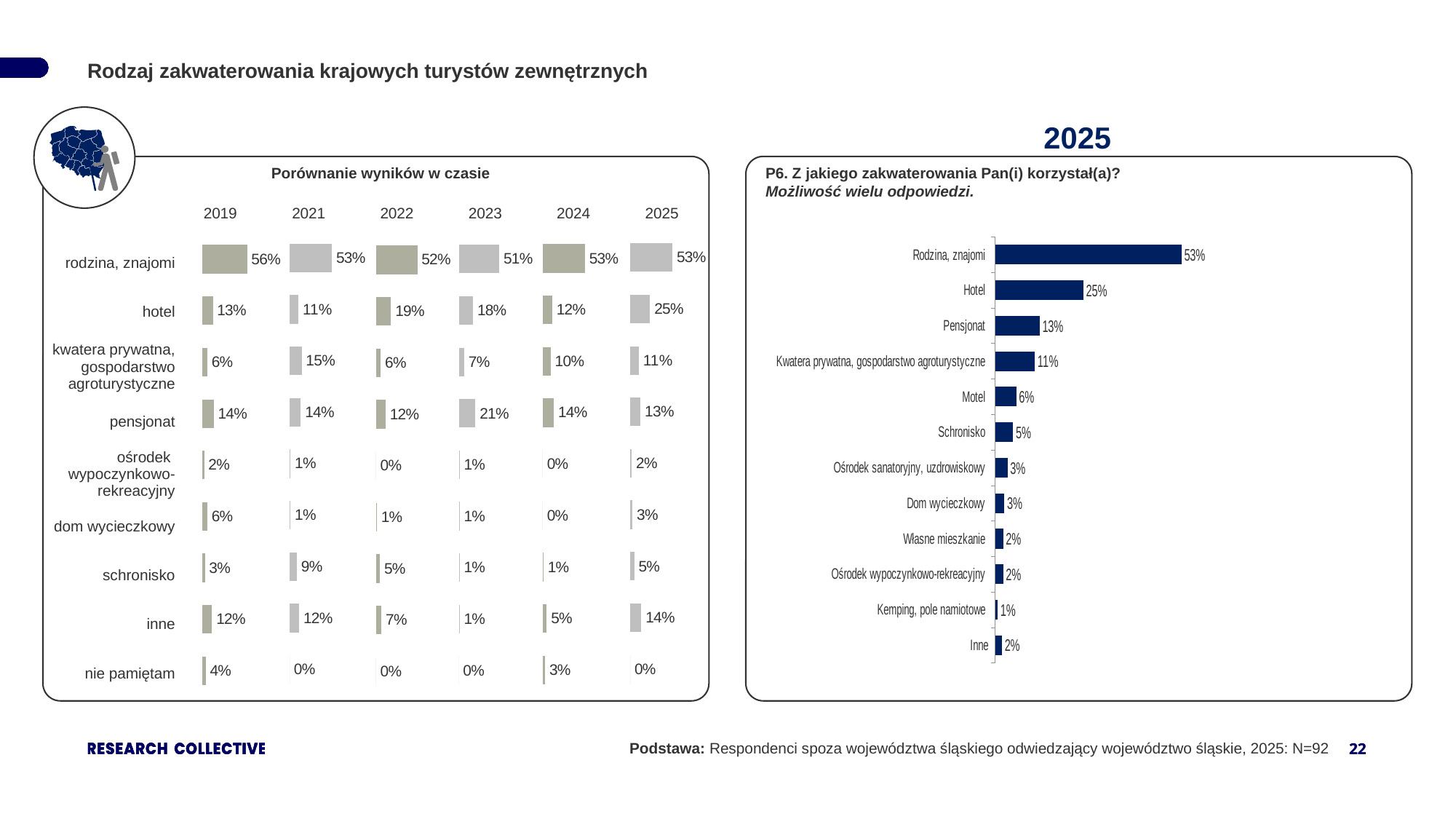
In the 2025 chart on the right, which is larger: Pensjonat or Motel? Pensjonat In the 'Porównanie wyników w czasie' chart on the left, what is the difference between hotel in 2025 and hotel in 2024? 13 percentage points In the 'Porównanie wyników w czasie' chart on the left, what is the value for rodzina, znajomi in 2019? 56% In the 2025 chart on the right, how many categories are shown? 12 In the 2025 chart on the right, what is the value for Hotel? 25% In the 'Porównanie wyników w czasie' chart on the left, how many years are compared? 6 In the 2025 chart on the right, which category has the lowest value? Kemping, pole namiotowe In the 2025 chart on the right, what is the difference between Rodzina, znajomi and Hotel? 28 percentage points In the 'Porównanie wyników w czasie' chart on the left, in which year was pensjonat highest? 2023 In the 2025 chart on the right, which category has the highest value? Rodzina, znajomi In the 'Porównanie wyników w czasie' chart on the left, what is the value for hotel in 2022? 19% What kind of chart is the 2025 chart on the right? Bar chart